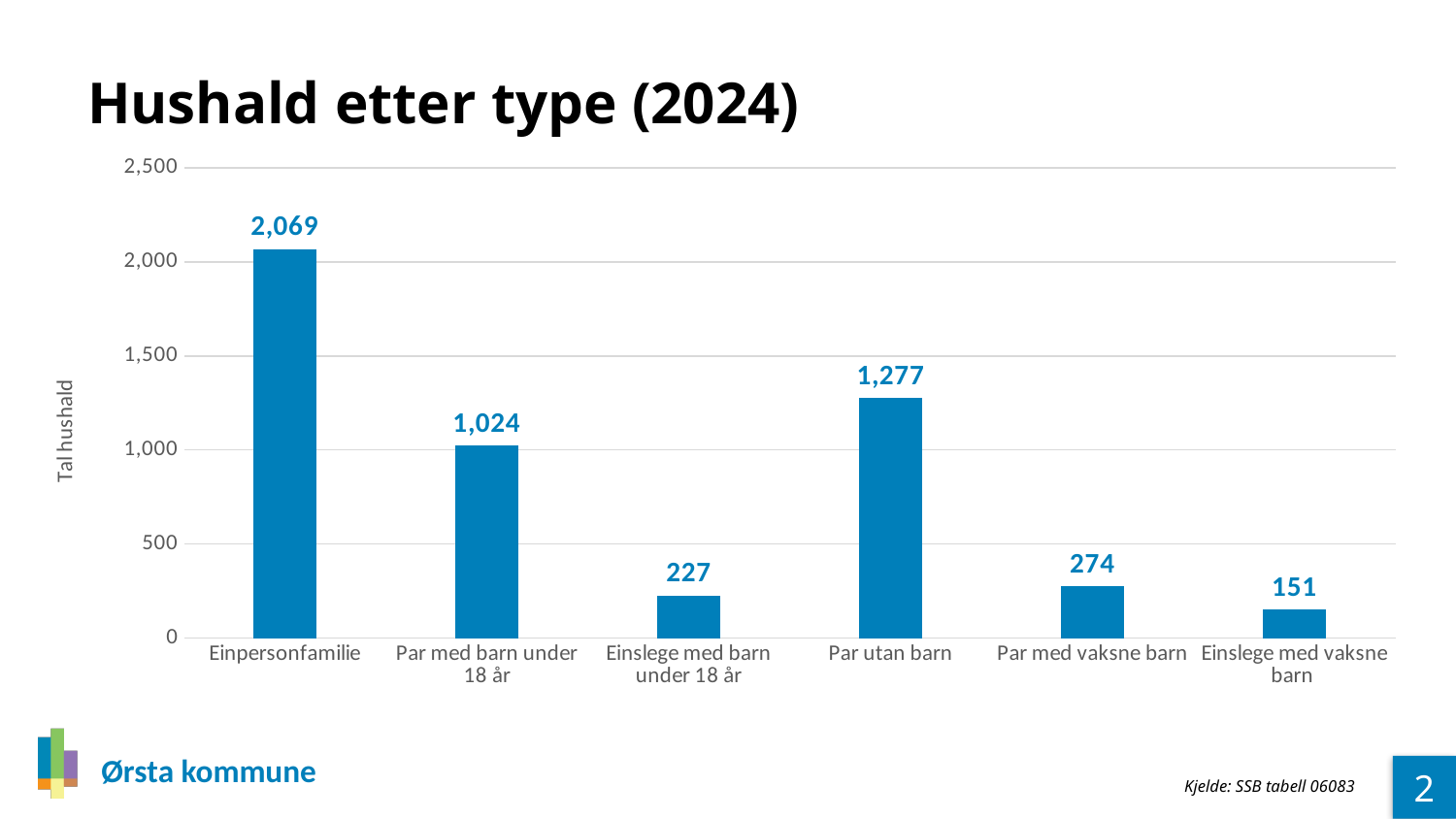
Which is larger, the value for Par med vaksne barn or the value for Einslege med barn under 18 år? Par med vaksne barn How many categories are shown on the x axis? 6 Which category has the lowest value? Einslege med vaksne barn Is the value for Par med barn under 18 år greater or less than 1,000? greater What is the value for Einslege med barn under 18 år? 227 What is the value for Einpersonfamilie? 2,069 What is the value for Par utan barn? 1,277 Which category has the highest value? Einpersonfamilie What is the title of the chart? Hushald etter type (2024) What kind of chart is shown on the slide? Bar chart What is the difference between the values for Par utan barn and Par med barn under 18 år? 253 What is the value for Einslege med vaksne barn? 151